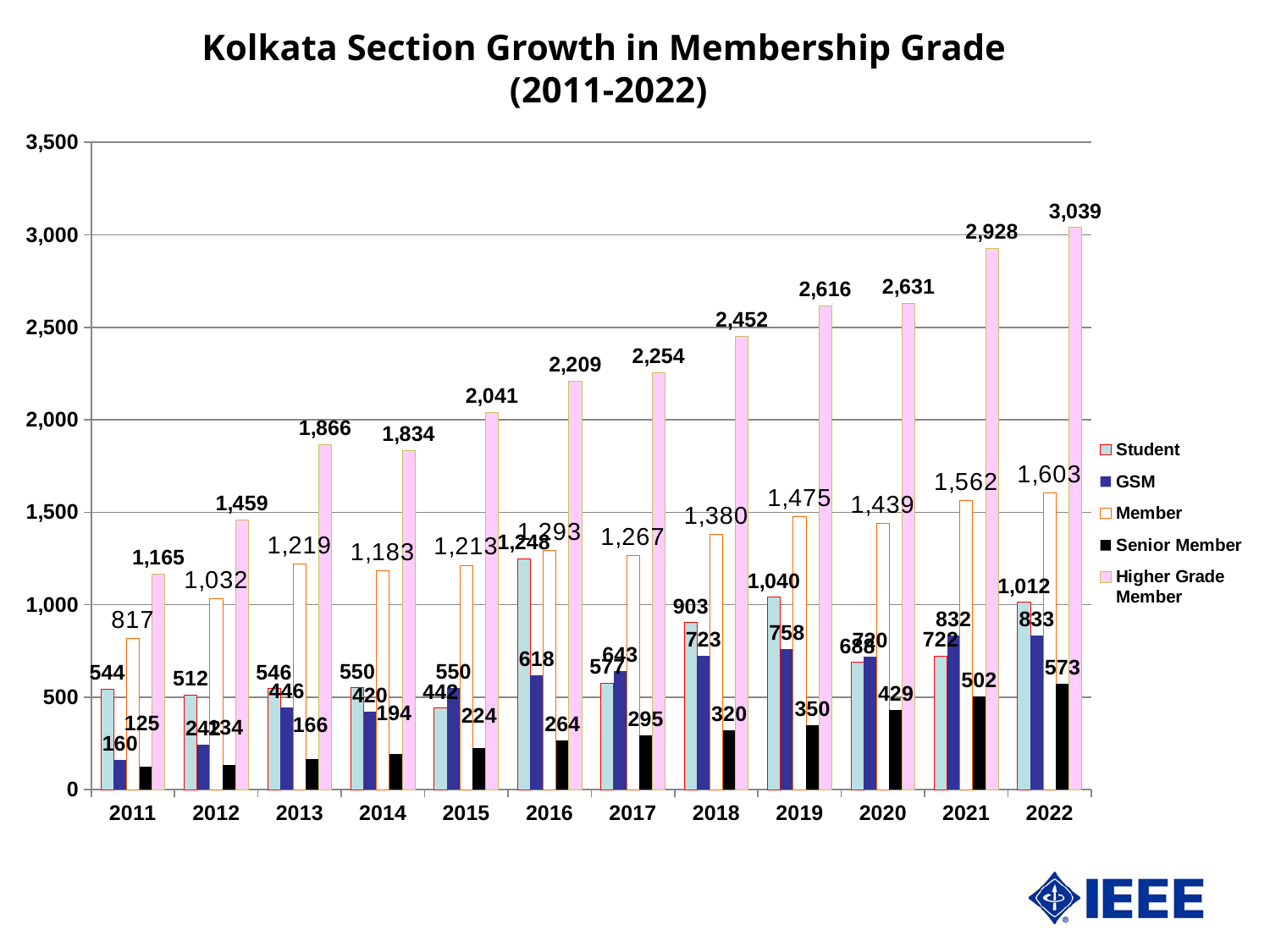
In which year is the Higher Grade Member value highest? 2022 What is the value for Senior Member in 2011? 125 How many years are shown on the x axis? 12 What is the value for Student in 2019? 1,040 How many series does the legend list? 5 Do the Senior Member values rise or fall from 2011 to 2022? Rise What is the value for Higher Grade Member in 2022? 3,039 What kind of chart is shown on the slide? Bar chart What is the difference between the Higher Grade Member values for 2022 and 2021? 111 In which year is the Senior Member value lowest? 2011 In 2016, which is larger: the Student value or the Member value? Member What is the value for Member in 2021? 1,562